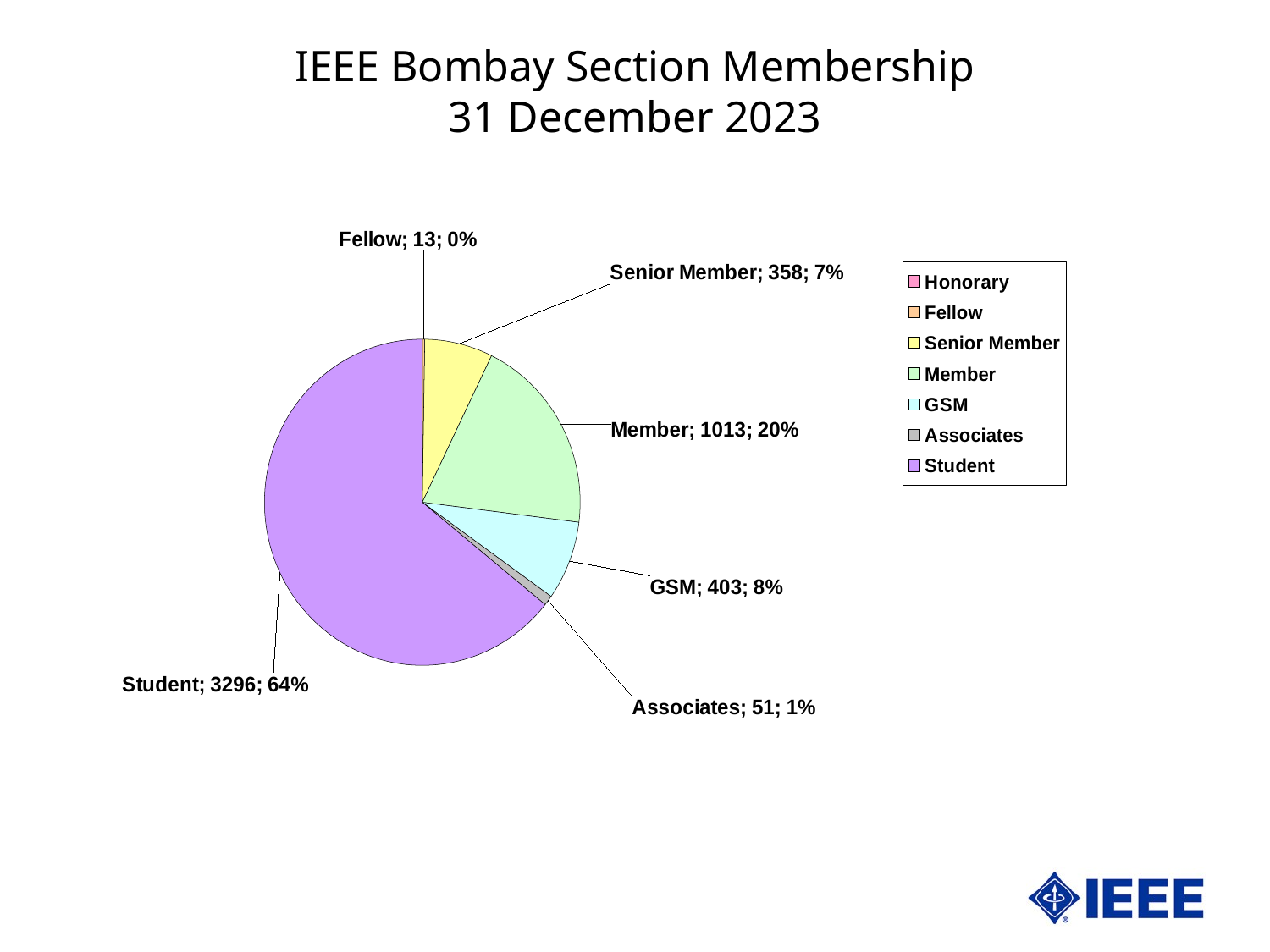
What share of the pie does the Student slice represent? 64% What is the value shown for Member? 1013 Which is larger, the value for Senior Member or the value for GSM? GSM What is the value shown for Senior Member? 358 What kind of chart is shown on the slide? pie chart What is the value shown for GSM? 403 What share of the pie does the Member slice represent? 20% Which labelled category has the smallest value? Fellow How many entries does the legend list? 7 What is the difference between the Member and GSM values? 610 Which category has the largest slice of the pie? Student How many members are in the Student category? 3296